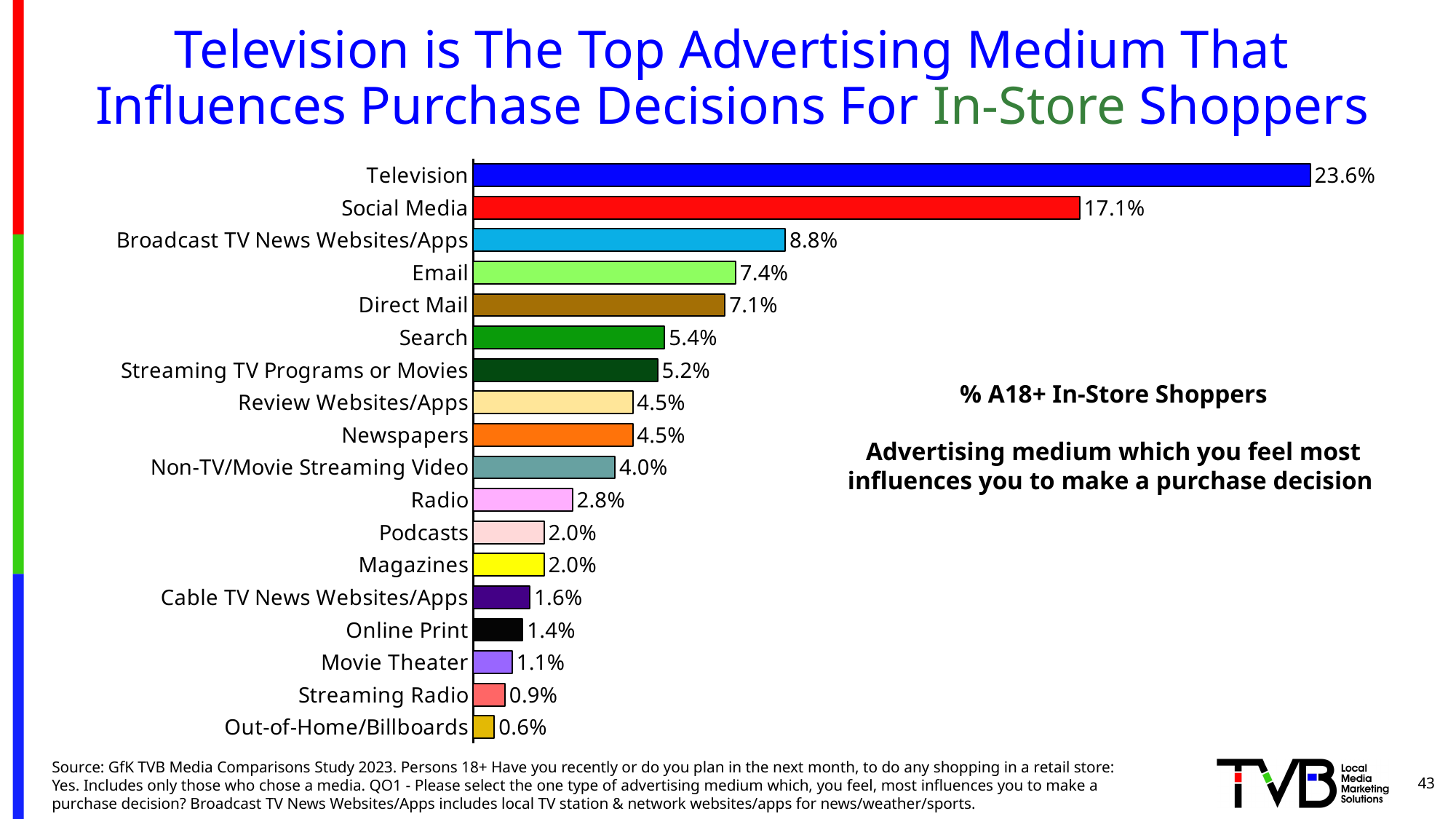
What is the value shown for Social Media? 17.1% What is the difference between the values for Television and Social Media? 6.5% How many advertising media are listed on the chart? 18 What is the difference between the values for Email and Direct Mail? 0.3% What percentage of in-store shoppers chose Television as the advertising medium that most influences their purchase decision? 23.6% What kind of chart is shown on the slide? Bar chart Which has a larger value, Radio or Podcasts? Radio Which advertising medium has the highest value on the chart? Television What is the value shown for Broadcast TV News Websites/Apps? 8.8% Which has a larger value, Search or Streaming TV Programs or Movies? Search What is the value shown for Direct Mail? 7.1% Which advertising medium has the lowest value on the chart? Out-of-Home/Billboards